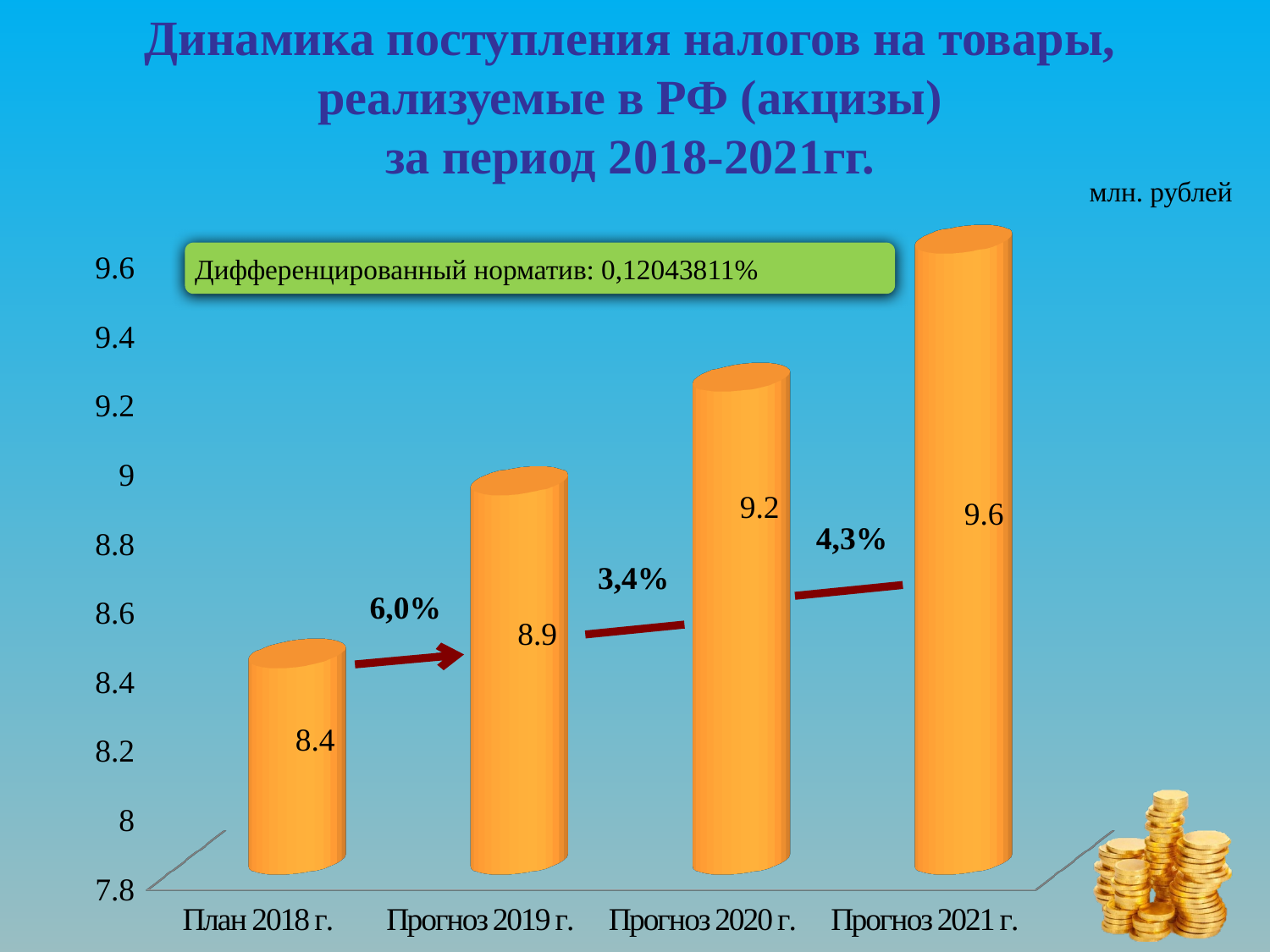
What is the difference between the values for Прогноз 2021 г. and План 2018 г.? 1.2 What kind of chart is shown on the slide? Bar chart What is the value for Прогноз 2021 г.? 9.6 Which is larger, the value for Прогноз 2019 г. or the value for Прогноз 2020 г.? Прогноз 2020 г. What is the value for Прогноз 2019 г.? 8.9 What is the value for Прогноз 2020 г.? 9.2 Do the values rise or fall from План 2018 г. to Прогноз 2021 г.? Rise Which category has the highest value? Прогноз 2021 г. How many categories are shown on the x axis? 4 What is the value for План 2018 г.? 8.4 Which category has the lowest value? План 2018 г. What is the difference between the values for Прогноз 2020 г. and Прогноз 2019 г.? 0.3